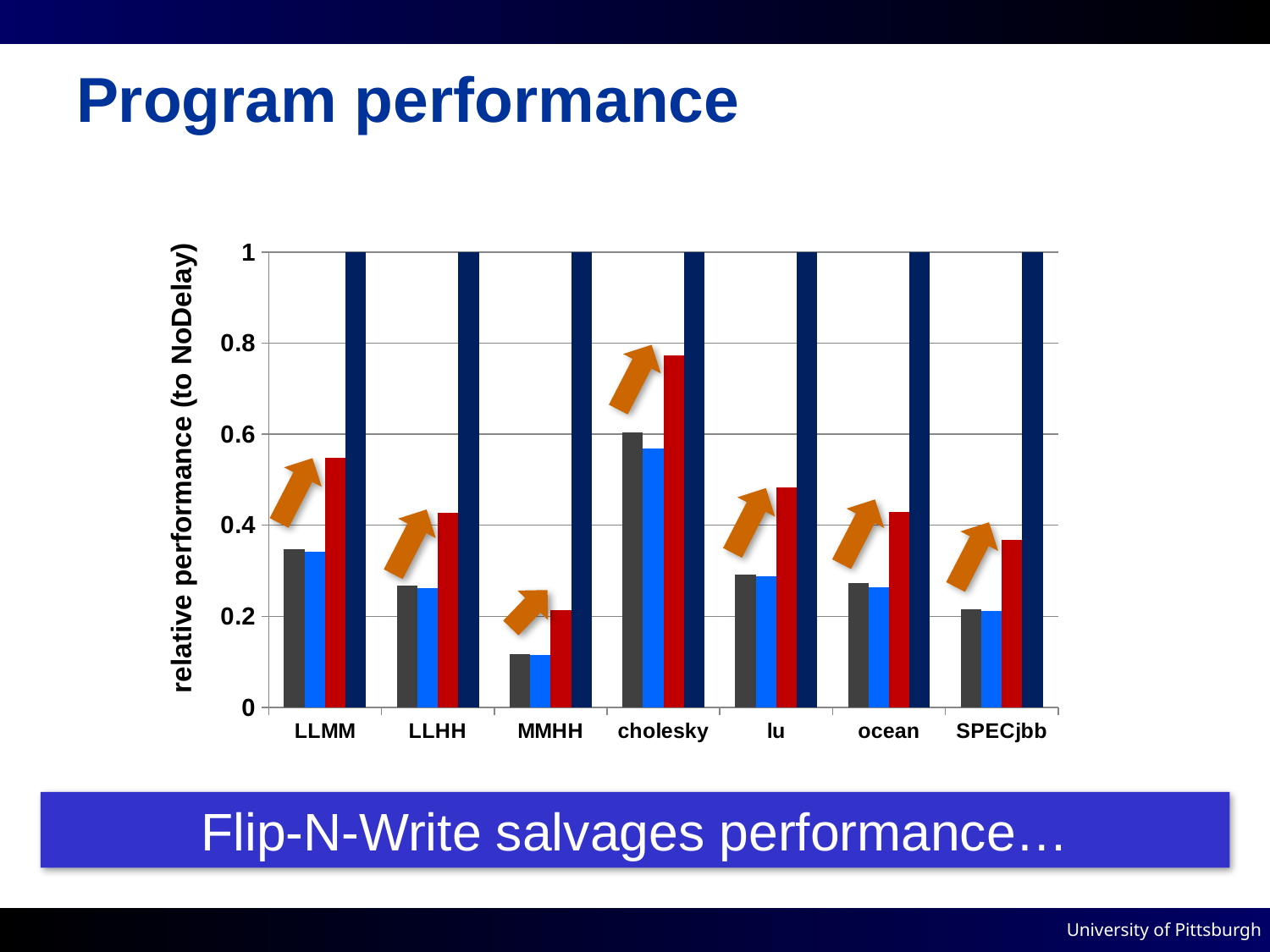
What kind of chart is shown on the slide? bar chart What value do the dark navy bars reach for every category? 1 Which category has the highest dark gray bar? cholesky How many bars are plotted for each category? 4 Is the red bar for MMHH greater or less than 0.4? less How many categories are shown along the x axis? 7 Is the dark gray bar for LLMM greater or less than 0.4? less Is the red bar for cholesky greater or less than 0.6? greater Among the red bars, which category has the highest value? cholesky For SPECjbb, which is larger: the red bar or the blue bar? the red bar What is the label of the y axis? relative performance (to NoDelay) Among the red bars, which category has the lowest value? MMHH